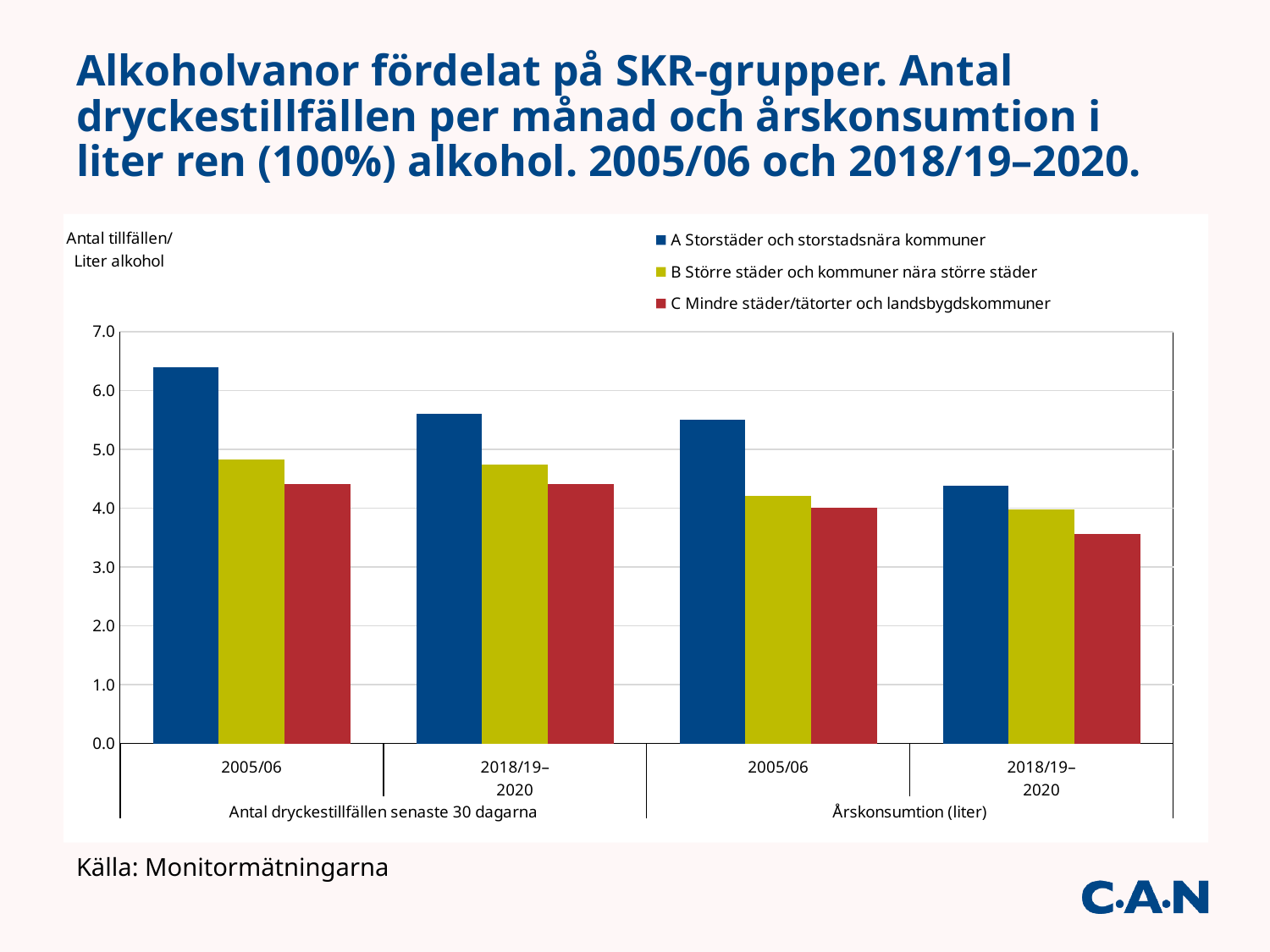
What kind of chart is shown on the slide? Bar chart Which bar is the lowest in the whole chart? C Mindre städer/tätorter och landsbygdskommuner, 2018/19–2020, Årskonsumtion (liter) Is the value for A Storstäder och storstadsnära kommuner in 2005/06 under Antal dryckestillfällen senaste 30 dagarna greater or less than 6.0? greater Is the value for B Större städer och kommuner nära större städer in 2005/06 under Antal dryckestillfällen senaste 30 dagarna greater or less than 5.0? less How many series does the legend list? 3 What colour represents C Mindre städer/tätorter och landsbygdskommuner in the chart? Red Is the value for C Mindre städer/tätorter och landsbygdskommuner in 2018/19–2020 under Årskonsumtion (liter) greater or less than 4.0? less Which series has the highest bar in every group? A Storstäder och storstadsnära kommuner How many bars are plotted in the chart in total? 12 Does the value for A Storstäder och storstadsnära kommuner under Antal dryckestillfällen senaste 30 dagarna rise or fall from 2005/06 to 2018/19–2020? Fall What source is given for the chart? Monitormätningarna Under Årskonsumtion (liter) in 2005/06, which is larger: A Storstäder och storstadsnära kommuner or C Mindre städer/tätorter och landsbygdskommuner? A Storstäder och storstadsnära kommuner